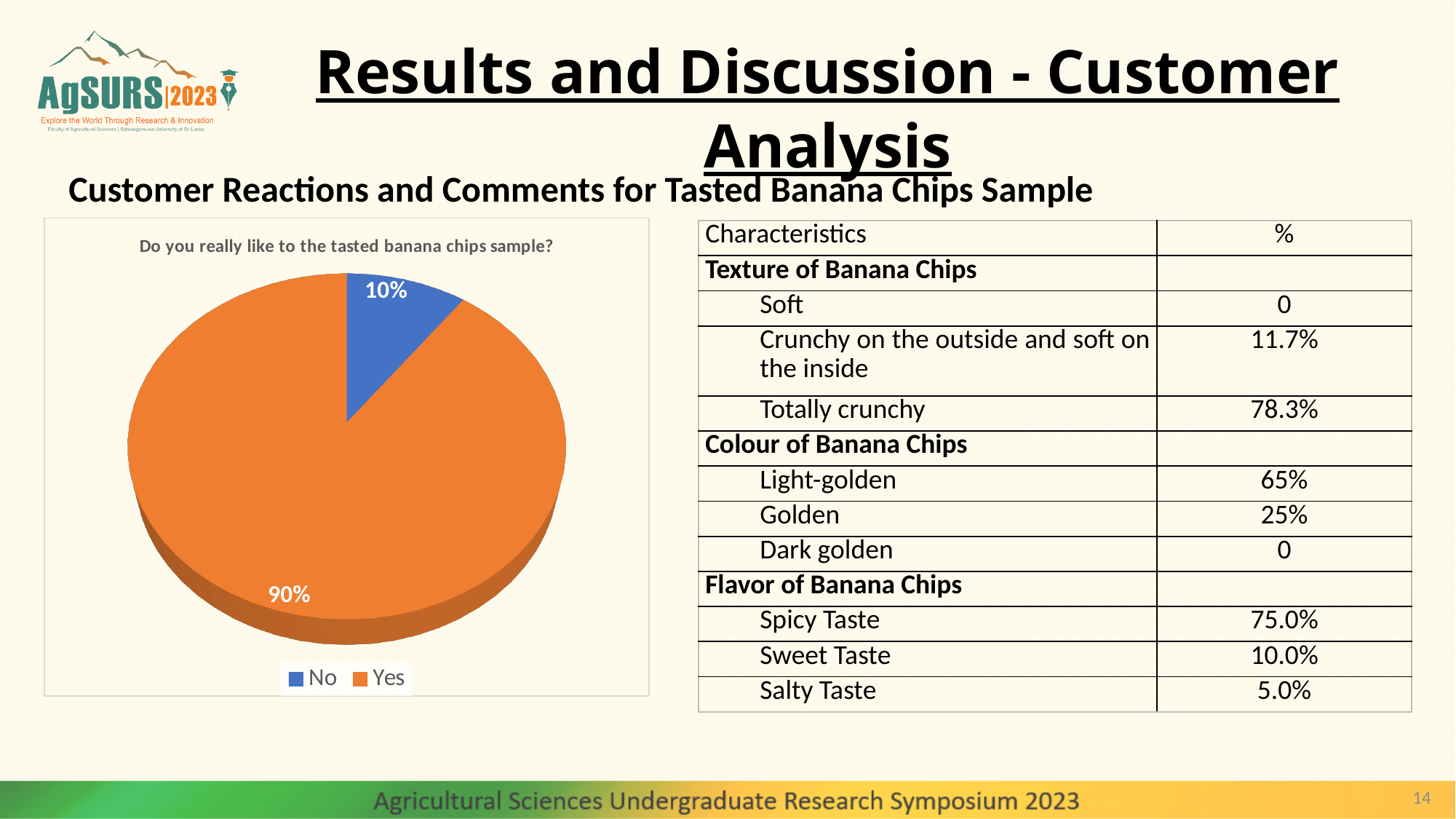
What colour is the "No" slice in the pie chart? blue Which is larger in the pie chart, the "Yes" slice or the "No" slice? Yes What share of the pie does the "No" slice represent? 10% What kind of chart is shown on the slide? pie chart Which slice of the pie chart is the largest? Yes What is the title of the pie chart? Do you really like to the tasted banana chips sample? Which slice of the pie chart is the smallest? No What percentage of the pie chart is labelled "Yes"? 90% What is the difference in percentage points between the "Yes" and "No" slices of the pie chart? 80 What percentage of the pie chart is labelled "No"? 10% How many slices does the pie chart have? 2 How many entries does the pie chart legend list? 2